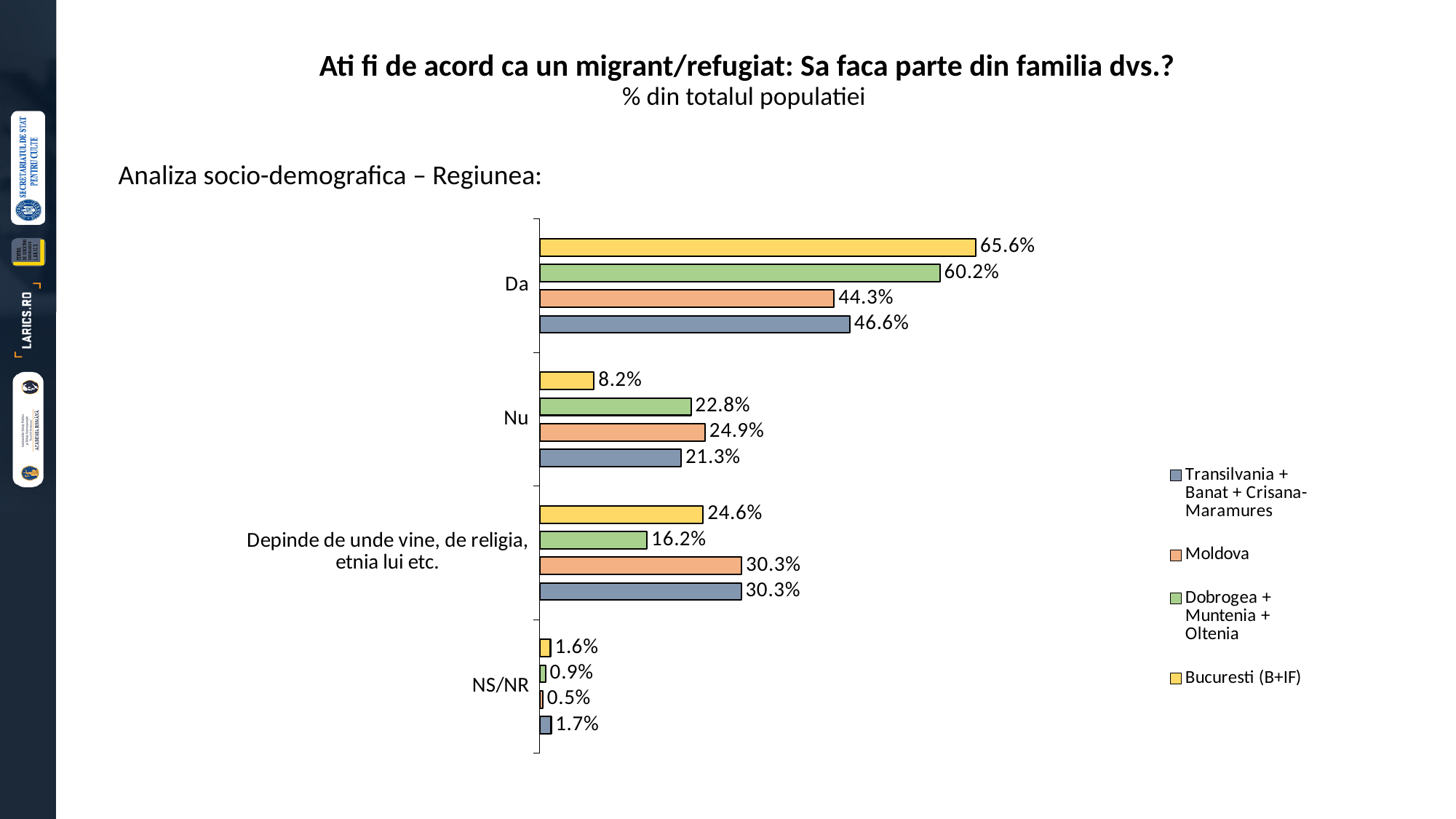
What kind of chart is shown on the slide? Bar chart What is the value for Bucuresti (B+IF) in the "Da" category? 65.6% What is the value for Moldova in the "Nu" category? 24.9% What is the value for Transilvania + Banat + Crisana-Maramures in the "NS/NR" category? 1.7% How many series does the legend list? 4 What is the value for Dobrogea + Muntenia + Oltenia in the "Depinde de unde vine, de religia, etnia lui etc." category? 16.2% How many response categories are shown on the chart? 4 In the "Nu" category, which is larger: the value for Dobrogea + Muntenia + Oltenia or the value for Transilvania + Banat + Crisana-Maramures? Dobrogea + Muntenia + Oltenia Which region has the lowest value in the "NS/NR" category? Moldova Which region has the lowest value in the "Nu" category? Bucuresti (B+IF) Which region has the highest value in the "Da" category? Bucuresti (B+IF) What is the difference between the Bucuresti (B+IF) and Moldova values in the "Da" category? 21.3%